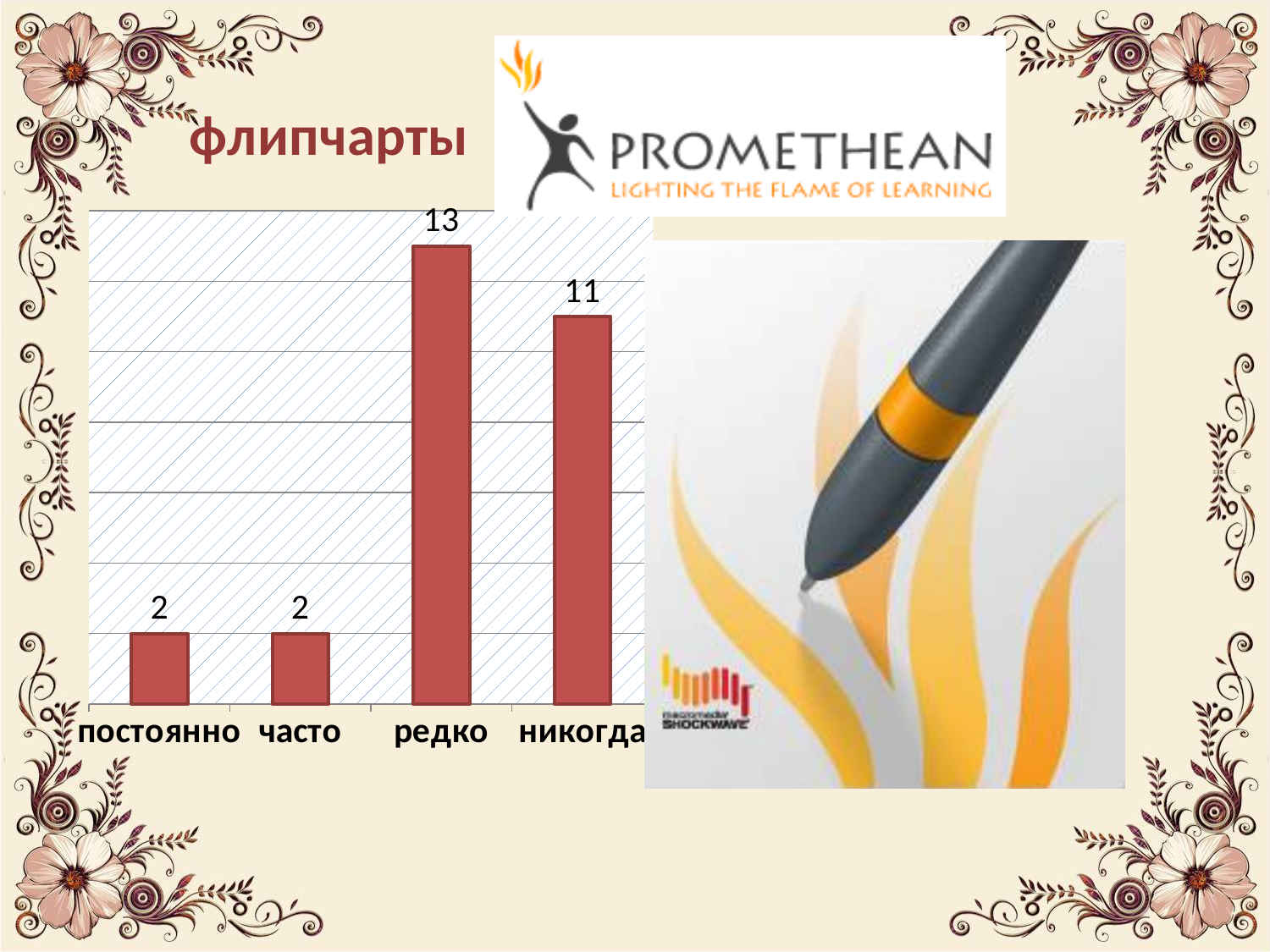
What is the value for постоянно? 2 What is the value for редко? 13 Which is larger, the value for редко or the value for никогда? редко What is the total of all four bar values? 28 What is the value for никогда? 11 What kind of chart is shown on the slide? bar chart What is the value for часто? 2 Which category has the highest value? редко What is the difference between the values for редко and никогда? 2 What is the difference between the values for никогда and часто? 9 How many categories are shown on the x axis? 4 What is the title shown above the chart? флипчарты